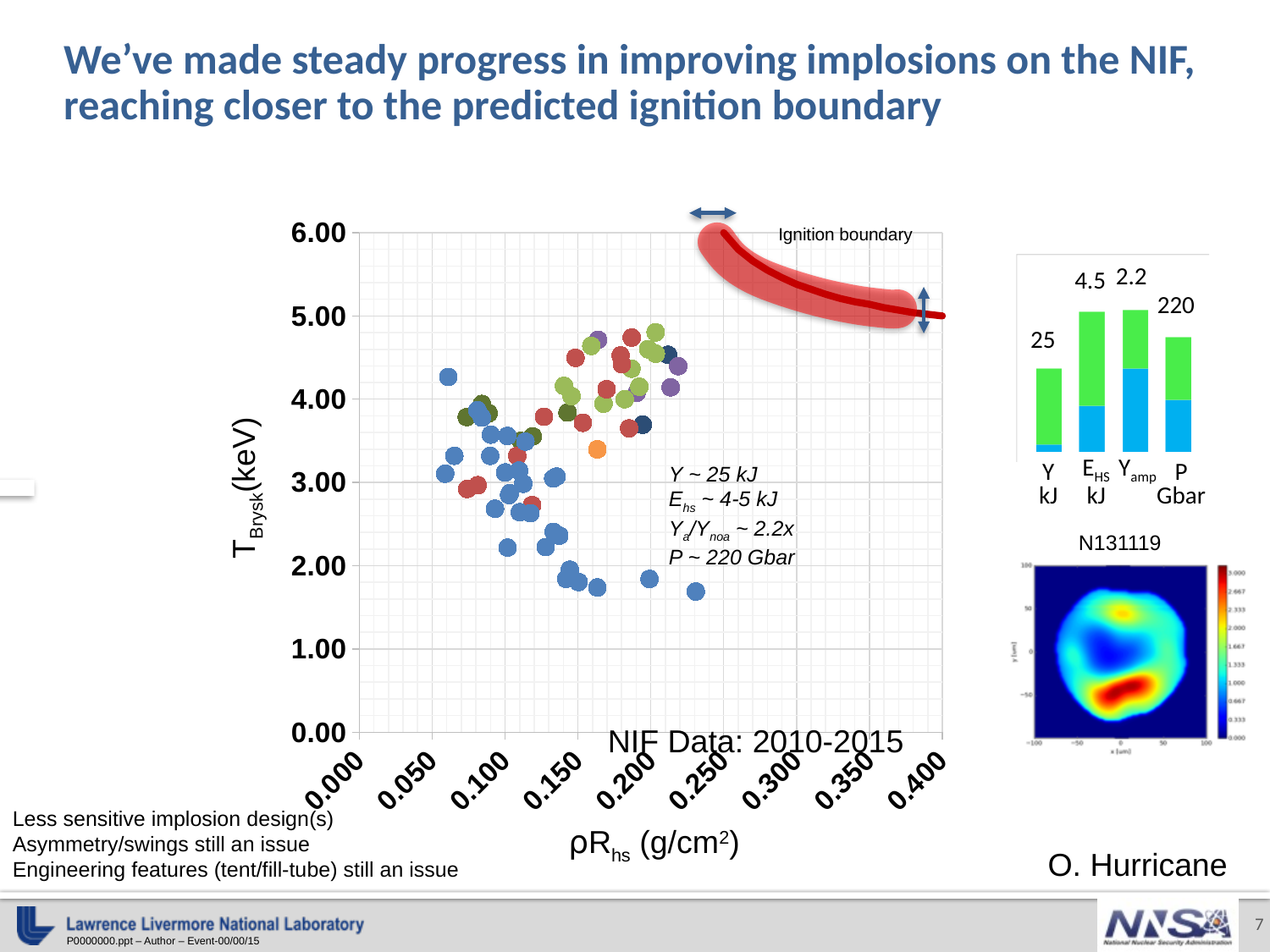
In the small bar chart on the right, which has the larger printed value, P or Y? P In the small bar chart on the right, how many categories are shown? 4 In the scatter chart 'NIF Data: 2010-2015', what is the red curve in the upper right labelled? Ignition boundary In the small bar chart on the right, what value is printed above the Y (kJ) bar? 25 In the scatter chart 'NIF Data: 2010-2015', what is the highest tick value shown on the y axis? 6.00 In the small bar chart on the right, what value is printed above the Y_amp bar? 2.2 In the scatter chart 'NIF Data: 2010-2015', what is the highest tick value shown on the x axis? 0.400 In the small bar chart on the right, what value is printed above the E_HS (kJ) bar? 4.5 In the small bar chart on the right, what value is printed above the P (Gbar) bar? 220 What kind of chart is the small chart on the right with categories Y, E_HS, Y_amp and P? bar chart What kind of chart is the large chart titled 'NIF Data: 2010-2015'? scatter chart